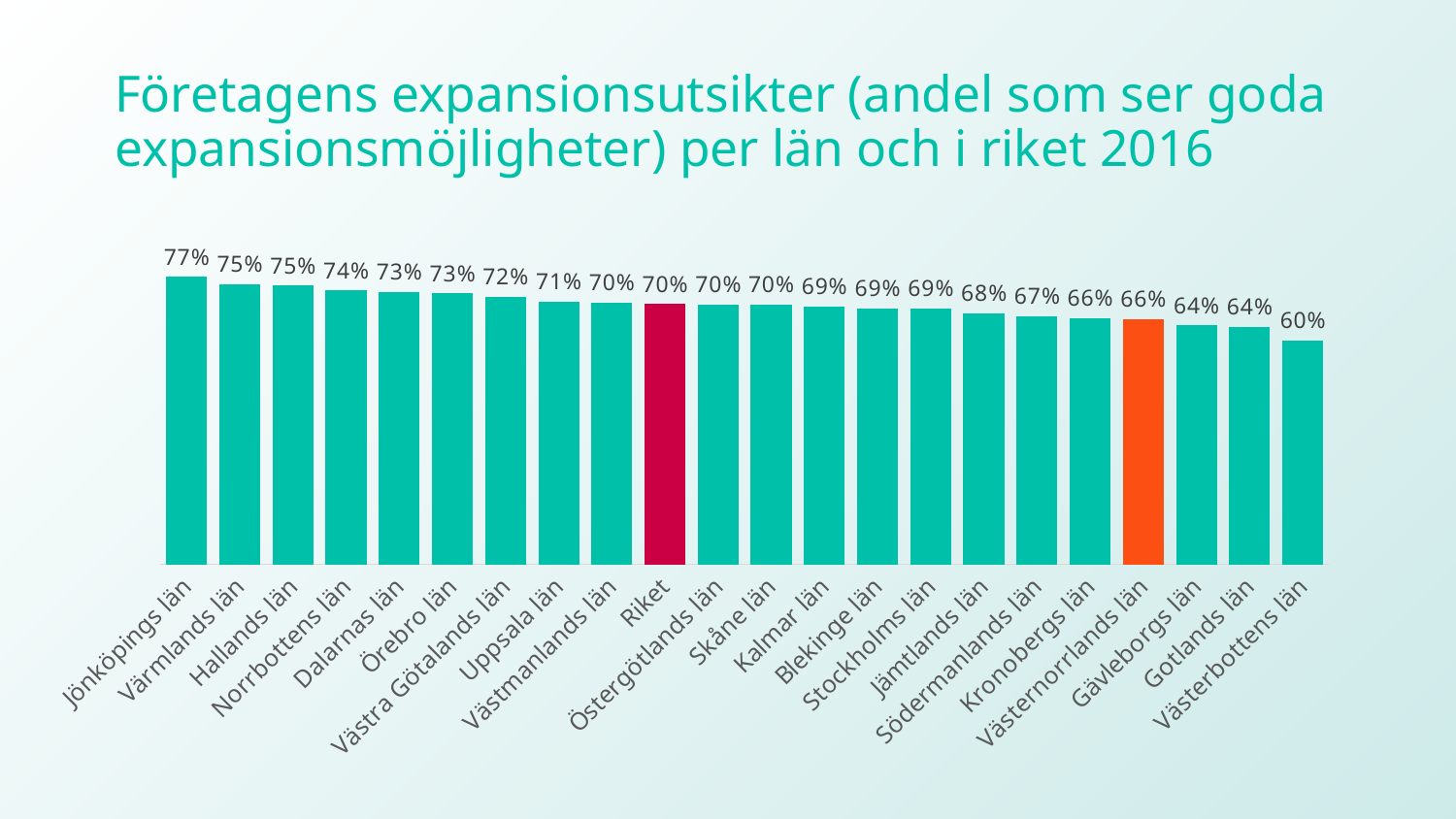
Which category has the lowest value? Västerbottens län How many bars are shown in the chart? 22 Which bar is coloured orange? Västernorrlands län What is the value for Västernorrlands län? 66% What is the value for Jönköpings län? 77% What is the value for Riket? 70% What kind of chart is shown on the slide? Bar chart What is the difference between the values for Jönköpings län and Västerbottens län? 17% Which category has the highest value? Jönköpings län Do the values rise or fall from left to right along the x axis? Fall What is the value for Stockholms län? 69% Which is larger, the value for Norrbottens län or the value for Gotlands län? Norrbottens län